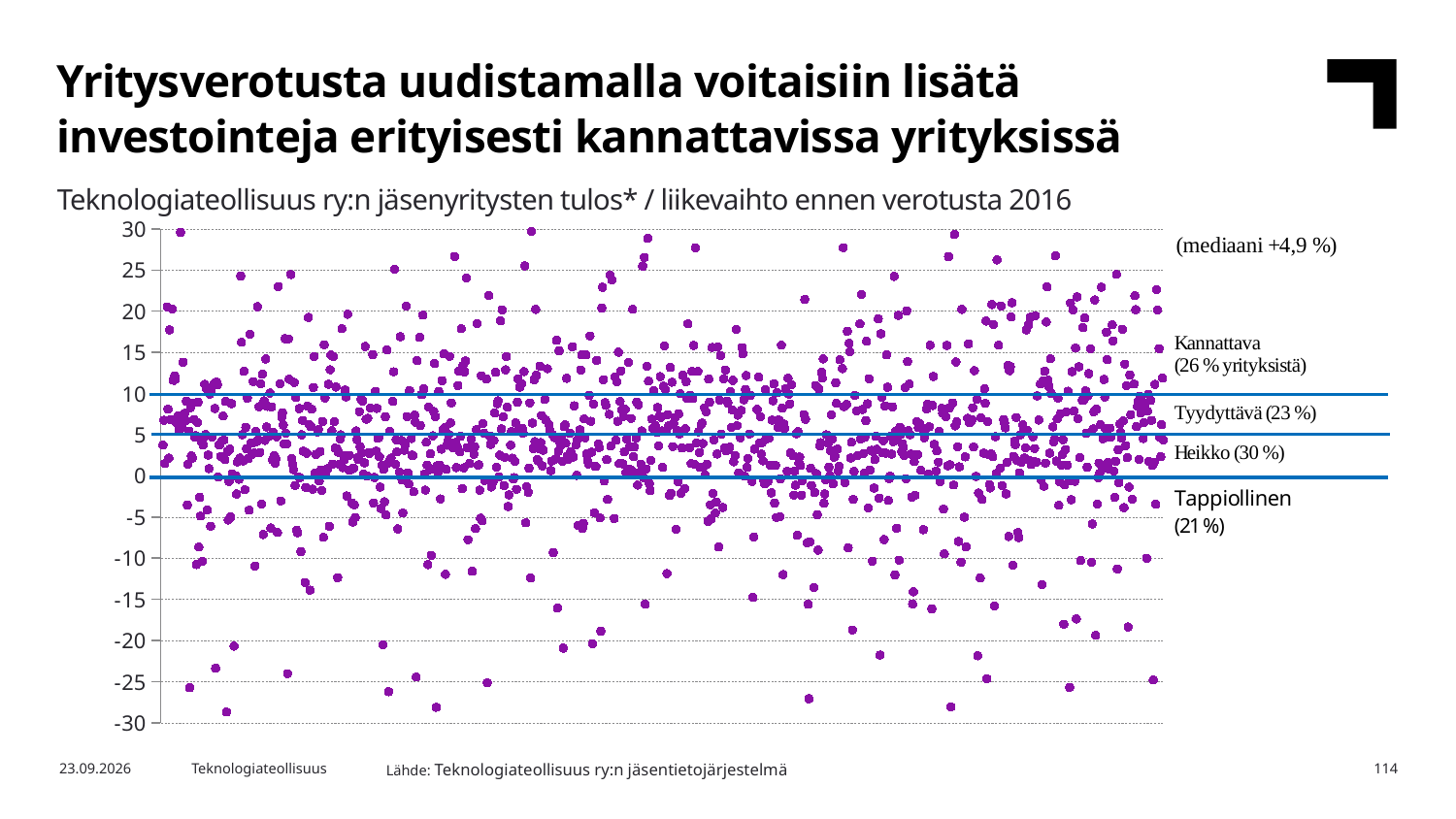
What share of companies is classified as Kannattava? 26 % What share of companies is classified as Heikko? 30 % What kind of chart is shown on the slide? Scatter chart Which profitability category contains the smallest share of companies? Tappiollinen Which profitability category contains the largest share of companies? Heikko What share of companies is classified as Tappiollinen? 21 % What is the median value of tulos / liikevaihto shown on the chart? +4,9 % Which category has a larger share of companies, Kannattava or Tyydyttävä? Kannattava How many percentage points larger is the Heikko share than the Tappiollinen share? 9 How many profitability categories are labelled on the chart? 4 What is the title of the chart? Teknologiateollisuus ry:n jäsenyritysten tulos* / liikevaihto ennen verotusta 2016 What share of companies is classified as Tyydyttävä? 23 %